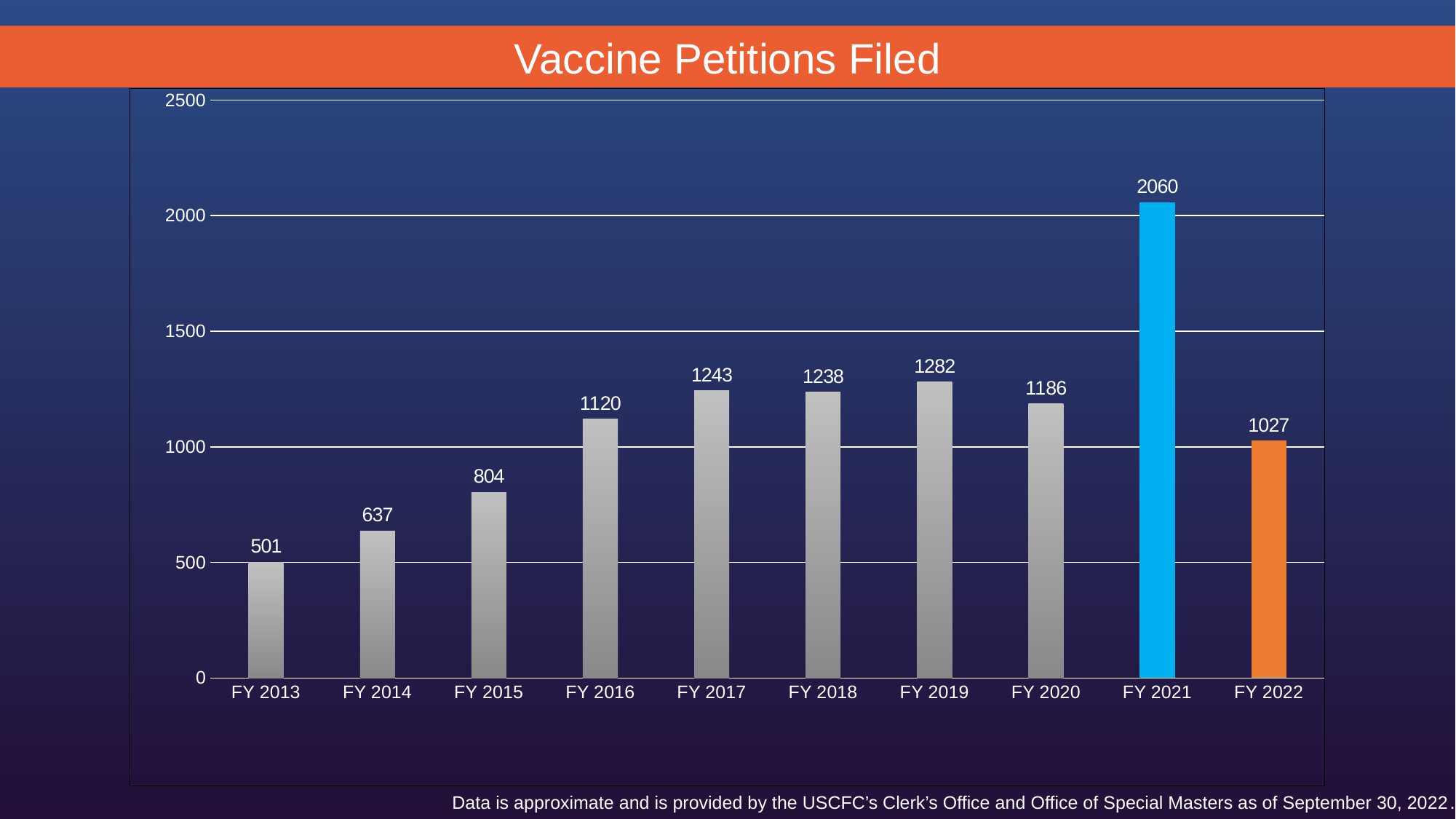
Which is larger, the value for FY 2017 or the value for FY 2018? FY 2017 What is the difference between the values for FY 2021 and FY 2022? 1033 What colour is the bar for FY 2022? orange What is the title of the chart? Vaccine Petitions Filed Is the value for FY 2020 greater or less than 1000? greater What kind of chart is shown on the slide? bar chart What is the value shown for FY 2022? 1027 Which fiscal year has the lowest number of vaccine petitions filed? FY 2013 How many fiscal years are shown on the x axis? 10 How many vaccine petitions were filed in FY 2016? 1120 Do the values rise or fall from FY 2013 to FY 2017? rise Which fiscal year has the highest number of vaccine petitions filed? FY 2021